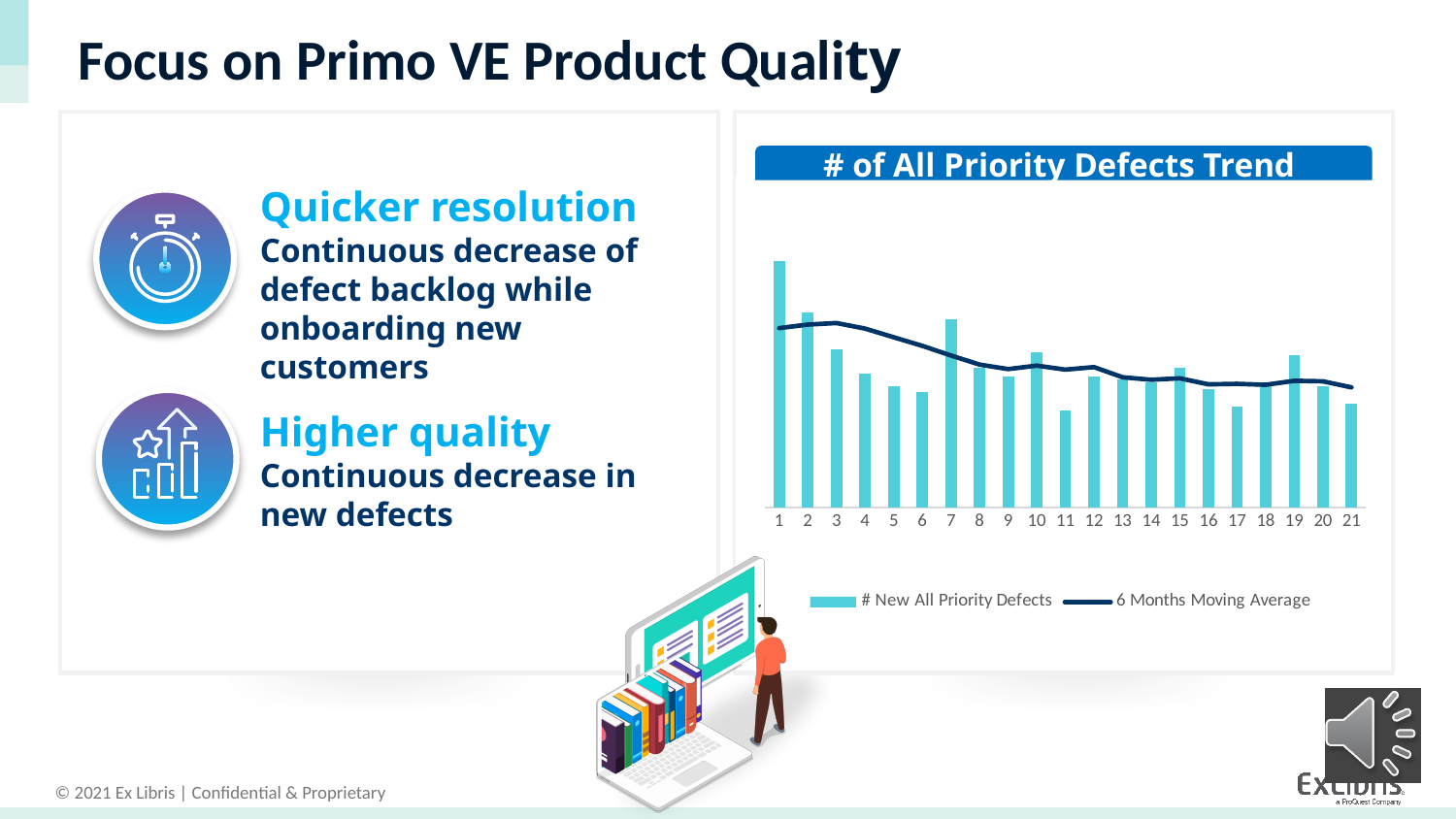
What kind of chart is used to show the # New All Priority Defects series? bar chart What does the dark line series in the chart represent, according to the legend? 6 Months Moving Average How many series does the chart legend list? 2 Which has more new all priority defects, category 18 or category 19? 19 Which category has the highest number of new all priority defects? 1 Which has more new all priority defects, category 1 or category 21? 1 Which has more new all priority defects, category 6 or category 7? 7 Does the 6 Months Moving Average line generally rise or fall from category 1 to category 21? fall How many categories are shown on the x axis of the chart? 21 Which category has the lowest number of new all priority defects? 11 What is the title of the chart? # of All Priority Defects Trend